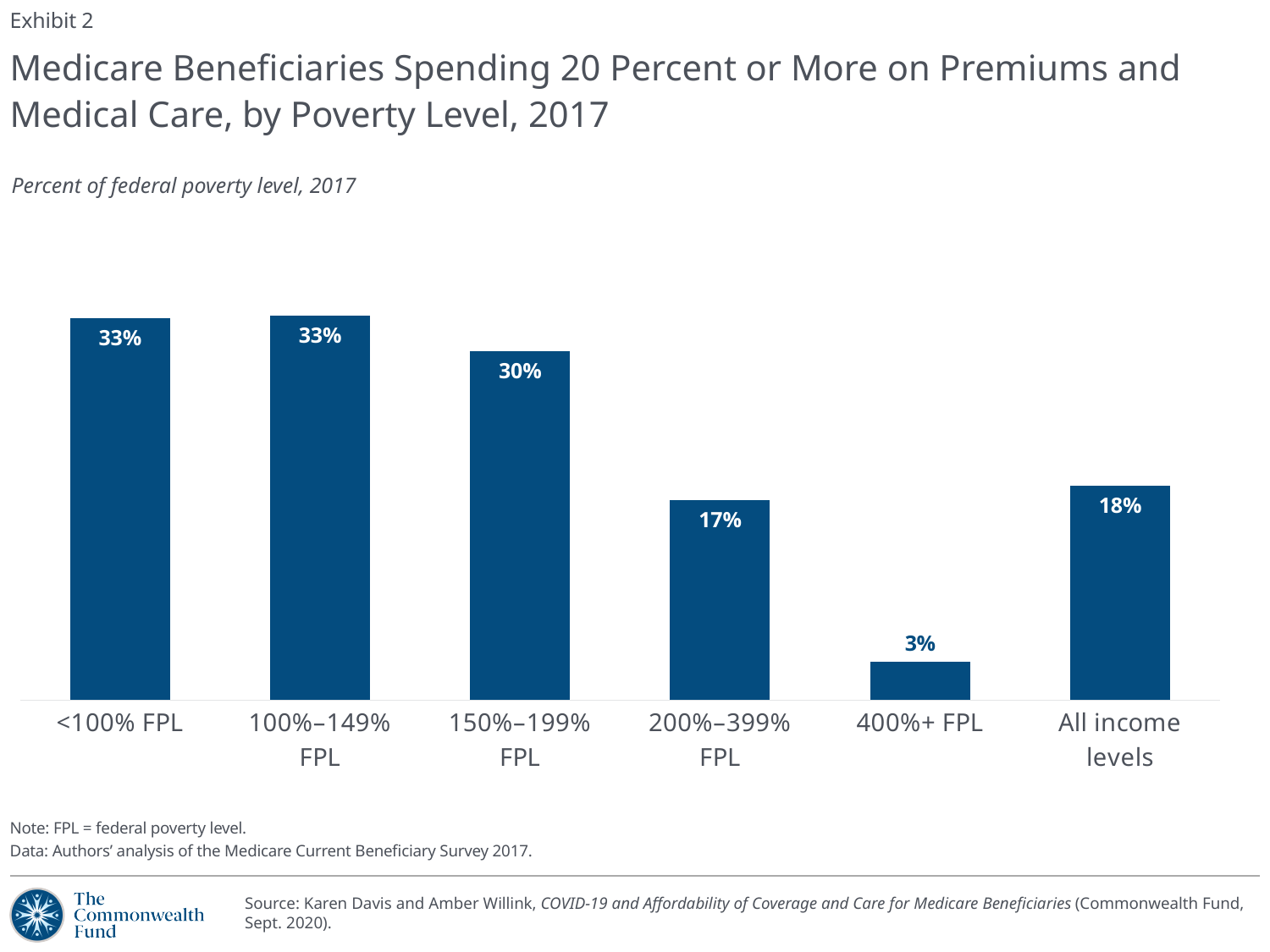
Which poverty level category has the lowest value? 400%+ FPL How many categories are shown on the x axis? 6 What kind of chart is shown on the slide? Bar chart Which is larger, the value for 100%–149% FPL or the value for 150%–199% FPL? 100%–149% FPL Which is larger, the value for 200%–399% FPL or the value for All income levels? All income levels What is the value shown for the 400%+ FPL category? 3% What percentage of Medicare beneficiaries at 150%–199% FPL spent 20 percent or more on premiums and medical care? 30% What is the difference between the values for <100% FPL and 400%+ FPL? 30 percentage points What is the value shown for the 200%–399% FPL category? 17% Do the values generally rise or fall moving from <100% FPL to 400%+ FPL? Fall What is the difference between the values for 150%–199% FPL and 200%–399% FPL? 13 percentage points What is the value shown for All income levels? 18%